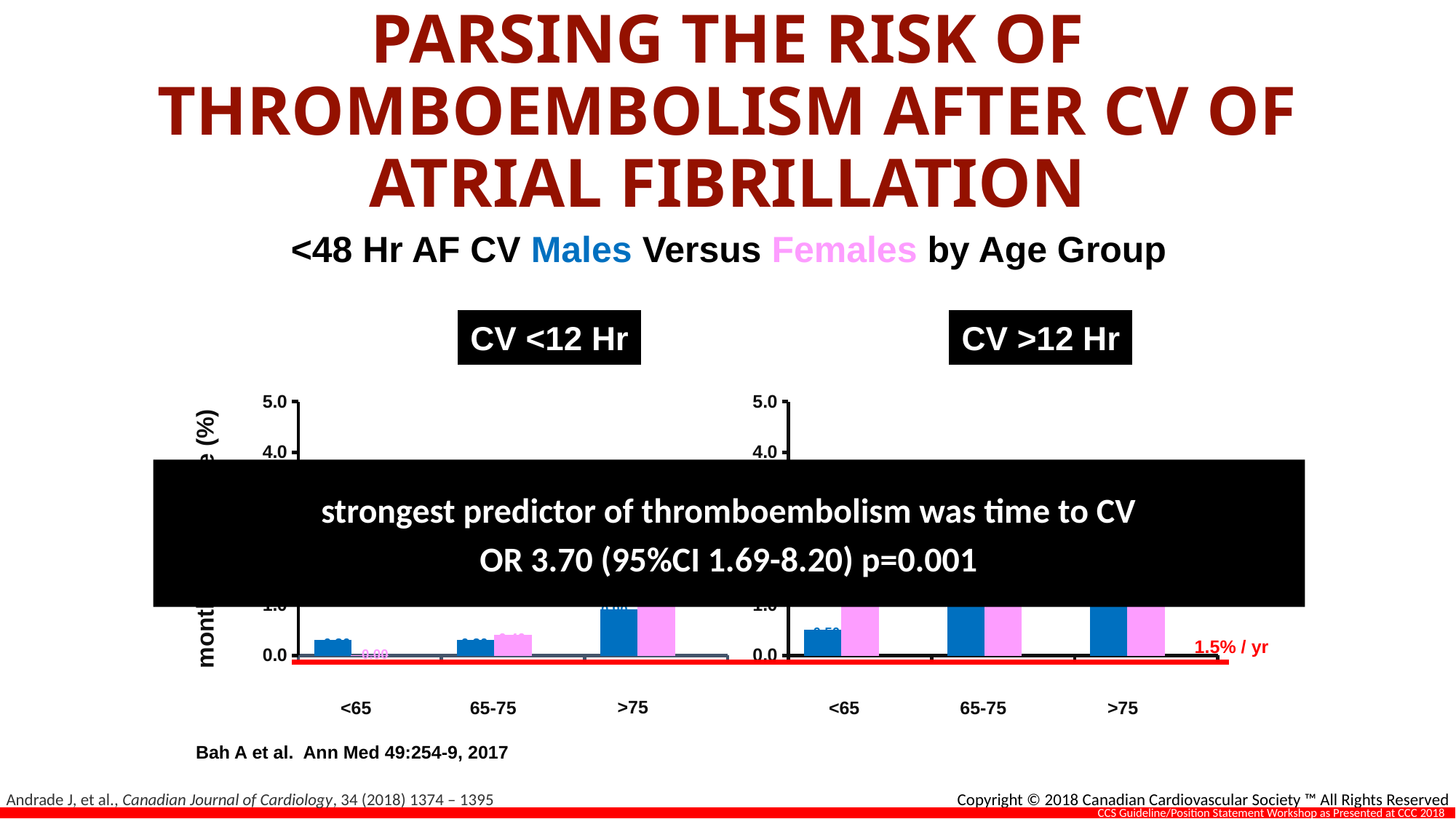
In the CV <12 Hr chart, do the Males values rise or fall as age group increases from <65 to >75? rise Which colour represents Males in the charts? blue In the CV >12 Hr chart, is the value for Males in the <65 age group greater or less than 1.0? less In the CV >12 Hr chart, which is larger for the <65 age group, Males or Females? Females How many age-group categories are shown on the x axis of the CV >12 Hr chart? 3 In the CV <12 Hr chart, is the value for Males in the <65 age group greater or less than 1.0? less In the CV <12 Hr chart, which is larger for Males, the <65 age group or the >75 age group? >75 In the CV <12 Hr chart, what is the value for Females in the <65 age group? 0.00 In the CV <12 Hr chart, which is larger for the <65 age group, Males or Females? Males What kind of chart is the CV <12 Hr chart? bar chart In the CV <12 Hr chart, is the value for Females in the 65-75 age group greater or less than 1.0? less How many series (sexes) are plotted in the CV <12 Hr chart? 2